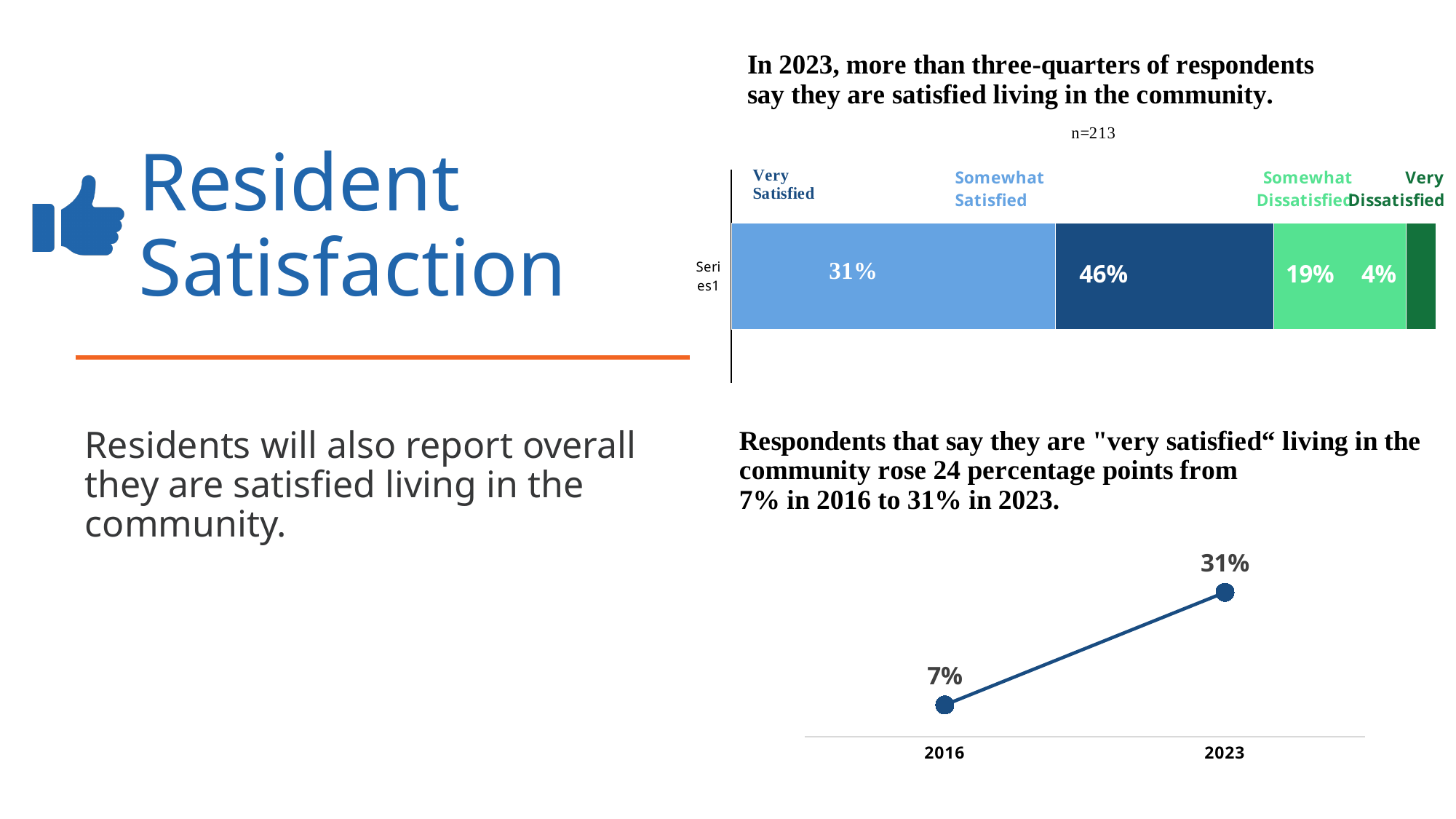
In the top stacked bar chart, what percentage of respondents are Somewhat Satisfied? 46% In the bottom line chart, what was the percentage of very satisfied respondents in 2016? 7% In the top stacked bar chart, which is larger: Very Satisfied or Somewhat Dissatisfied? Very Satisfied In the top stacked bar chart, what is the difference between the Somewhat Satisfied and Very Satisfied percentages? 15% In the top stacked bar chart, which category has the largest share? Somewhat Satisfied In the top stacked bar chart, which category has the smallest share? Very Dissatisfied In the top stacked bar chart, how many satisfaction categories are shown? 4 What is the sample size (n) shown above the top chart? n=213 In the top stacked bar chart, what percentage of respondents are Very Satisfied? 31% In the bottom line chart, does the value rise or fall from 2016 to 2023? rise In the bottom line chart, what was the percentage of very satisfied respondents in 2023? 31% In the top stacked bar chart, what percentage of respondents are Somewhat Dissatisfied? 19%